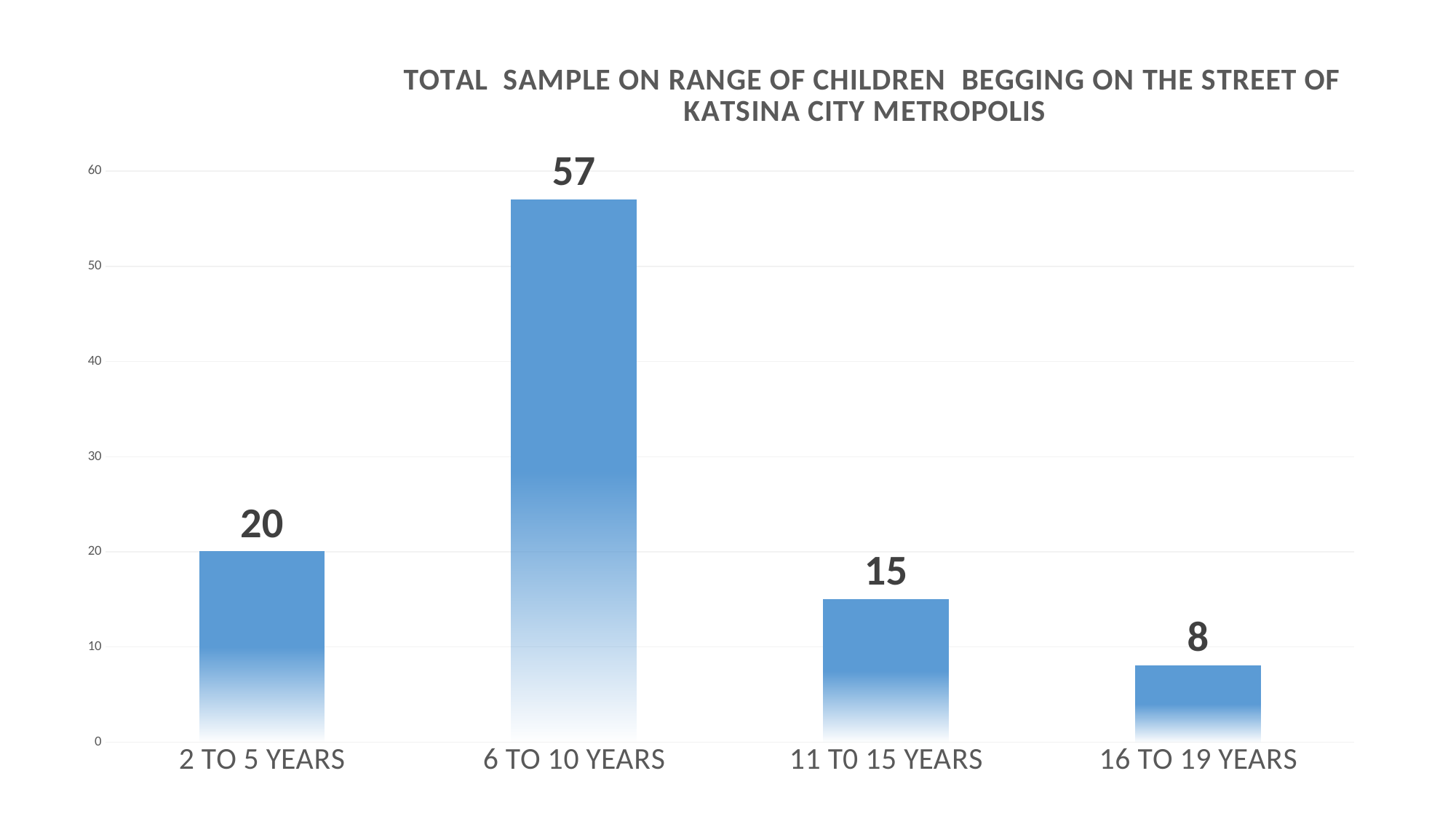
What is the difference between the values for 6 TO 10 YEARS and 2 TO 5 YEARS? 37 What is the difference between the values for 11 T0 15 YEARS and 16 TO 19 YEARS? 7 What is the title of the chart? TOTAL SAMPLE ON RANGE OF CHILDREN BEGGING ON THE STREET OF KATSINA CITY METROPOLIS How many age range categories are shown on the chart? 4 Which age range has the highest value? 6 TO 10 YEARS What is the value for the 2 TO 5 YEARS category? 20 Which age range has the lowest value? 16 TO 19 YEARS What kind of chart is shown on the slide? Bar chart Is the value for 6 TO 10 YEARS greater or less than 50? greater Which is larger, the value for 2 TO 5 YEARS or the value for 11 T0 15 YEARS? 2 TO 5 YEARS What is the value for the 16 TO 19 YEARS category? 8 What is the value for the 6 TO 10 YEARS category? 57